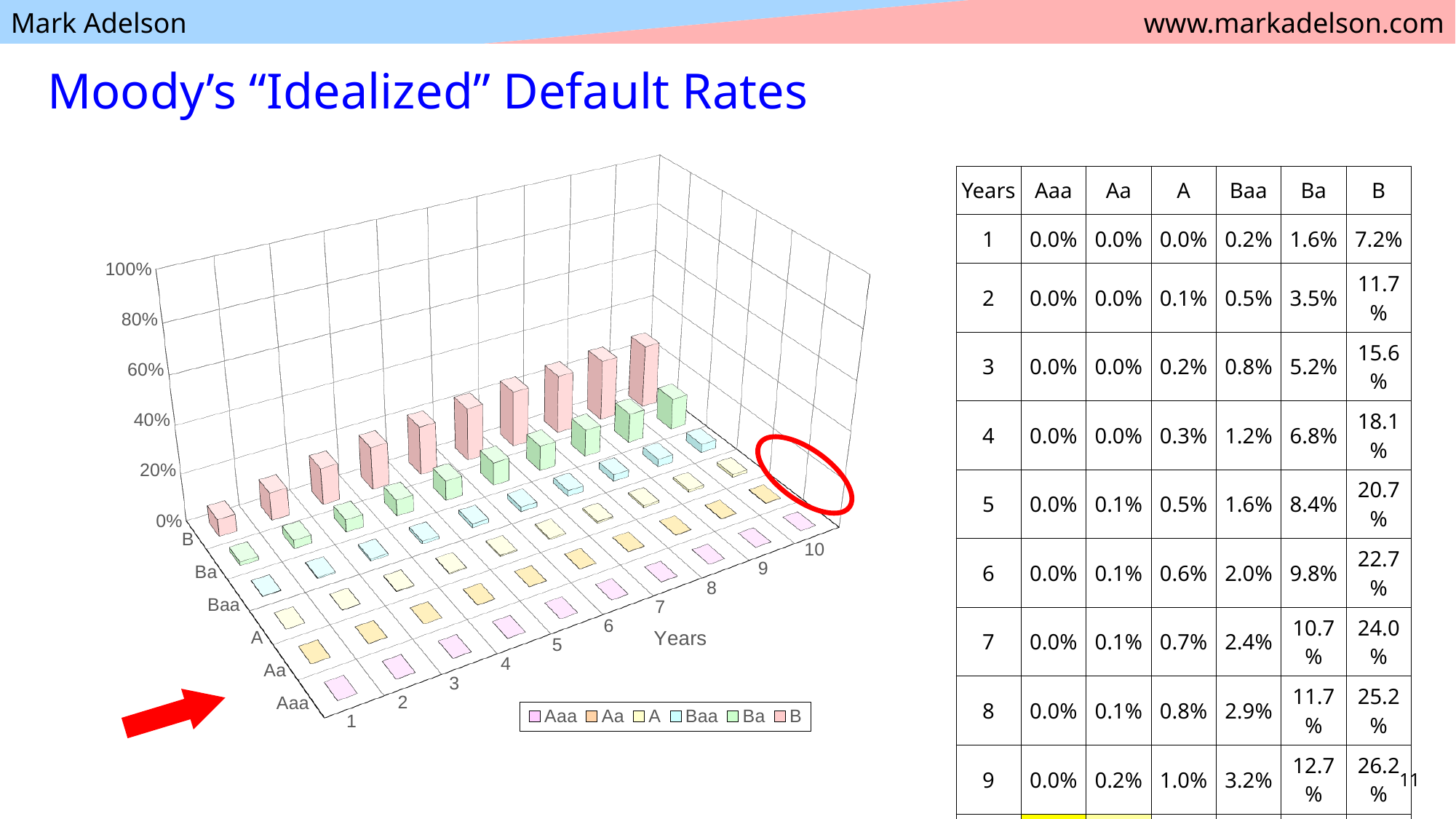
How many years are plotted along the Years axis of the chart? 10 Which rating series has the highest default rates in the chart? B What is the title of the chart's horizontal (depth) axis labelled 1 to 10? Years What kind of chart is shown on the slide? bar chart How many series does the chart's legend list? 6 Which rating series has the lowest default rates in the chart? Aaa What is the idealized default rate for B at year 1? 7.2% What is the idealized default rate for Ba at year 5? 8.4% What are the legend entries of the chart, in order? Aaa, Aa, A, Baa, Ba, B Is the default rate for Aaa at year 1 greater or less than 20%? less What is the difference between the B default rate at year 2 and at year 1? 4.5% Do the default rates for the B series rise or fall as the years increase? rise